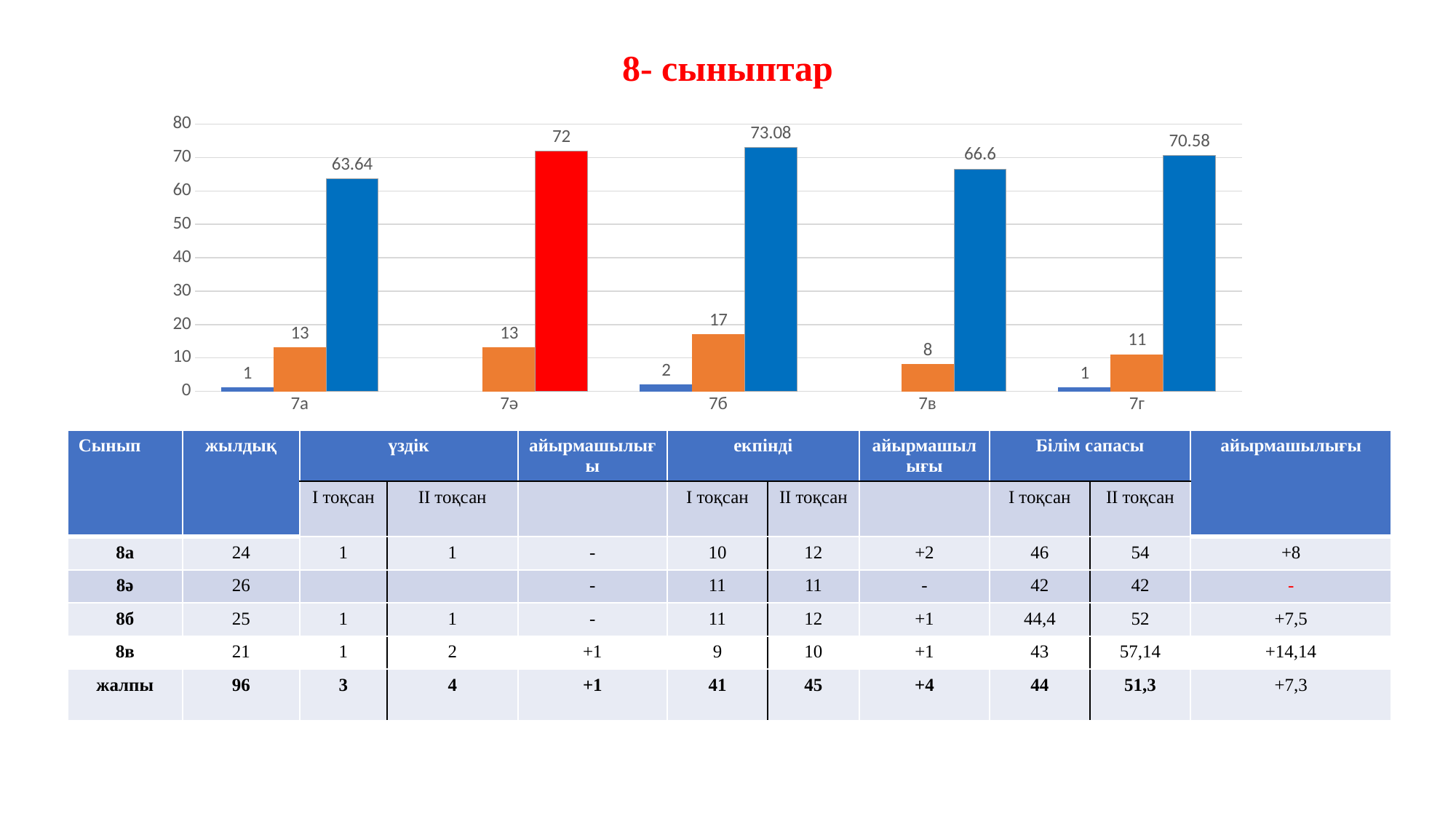
Is the value of the tall bar for 7в greater or less than 70? less What type of chart is shown on the slide? bar chart Which category has the lowest value among the tall bars? 7а Which category's tall bar is coloured red instead of blue? 7ә Which category has the highest value among the tall bars? 7б How many categories are shown on the x axis of the chart? 5 Is the tall bar for 7ә larger or smaller than the tall bar for 7г? larger Which category has the lowest orange bar value? 7в What is the value of the orange bar for category 7в? 8 What is the value of the tallest bar for category 7а? 63.64 What is the difference between the orange bar values for 7б and 7в? 9 What is the value of the tallest bar for category 7б? 73.08